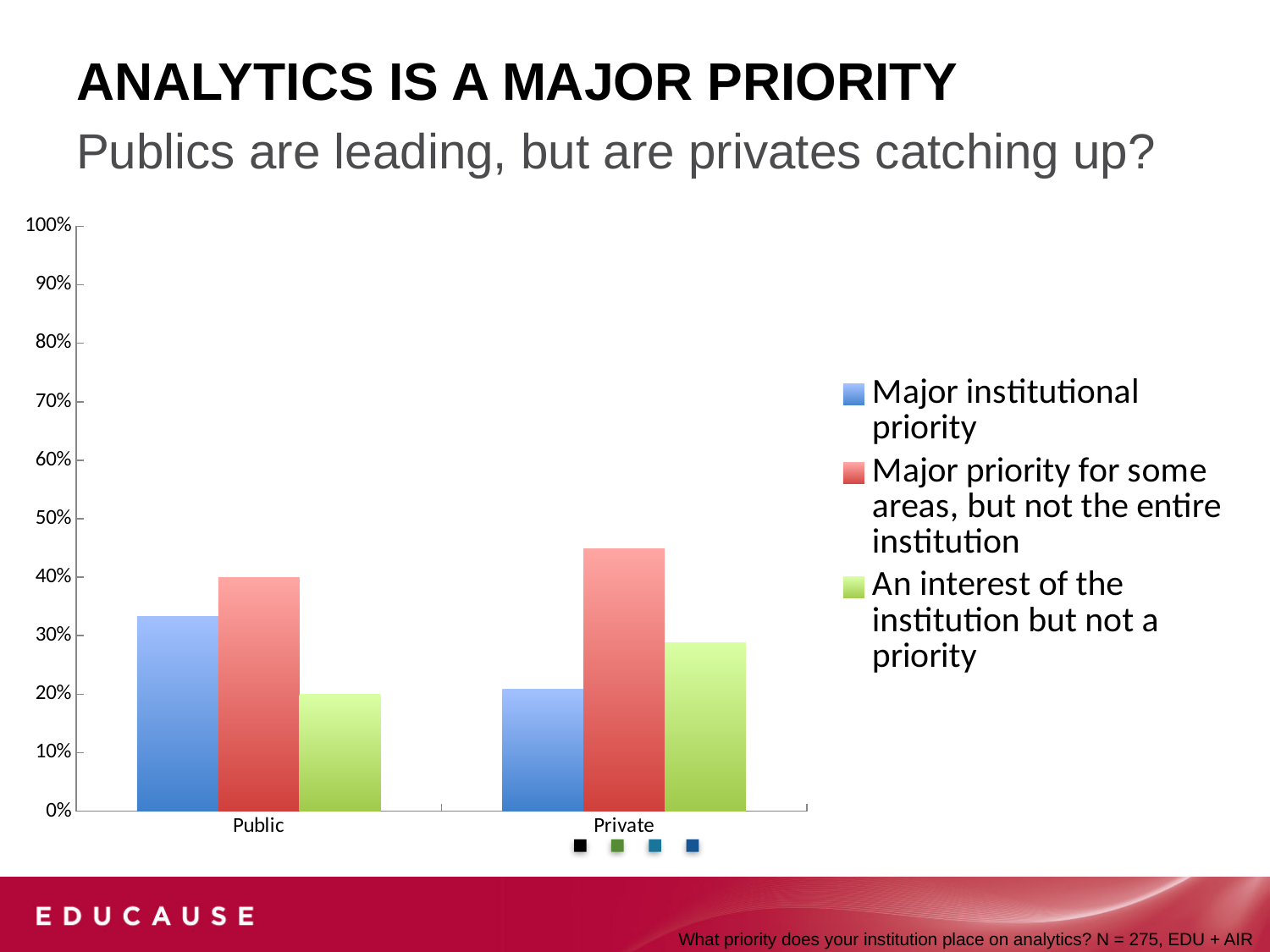
For the Public category, which series has the highest bar? Major priority for some areas, but not the entire institution What kind of chart is shown on the slide? bar chart Is the 'Major institutional priority' value for Private greater or less than 30%? less How many categories are shown on the x axis of the chart? 2 Is the 'Major priority for some areas, but not the entire institution' value for Private greater or less than 40%? greater What is the value for 'An interest of the institution but not a priority' in the Public category? 20% Is the 'An interest of the institution but not a priority' value larger for Public or for Private? Private Is the 'Major institutional priority' value larger for Public or for Private? Public For the Private category, which series has the lowest bar? Major institutional priority What colour represents 'Major institutional priority' in the chart? blue How many series does the chart's legend list? 3 Is the 'Major institutional priority' value for Public greater or less than 30%? greater